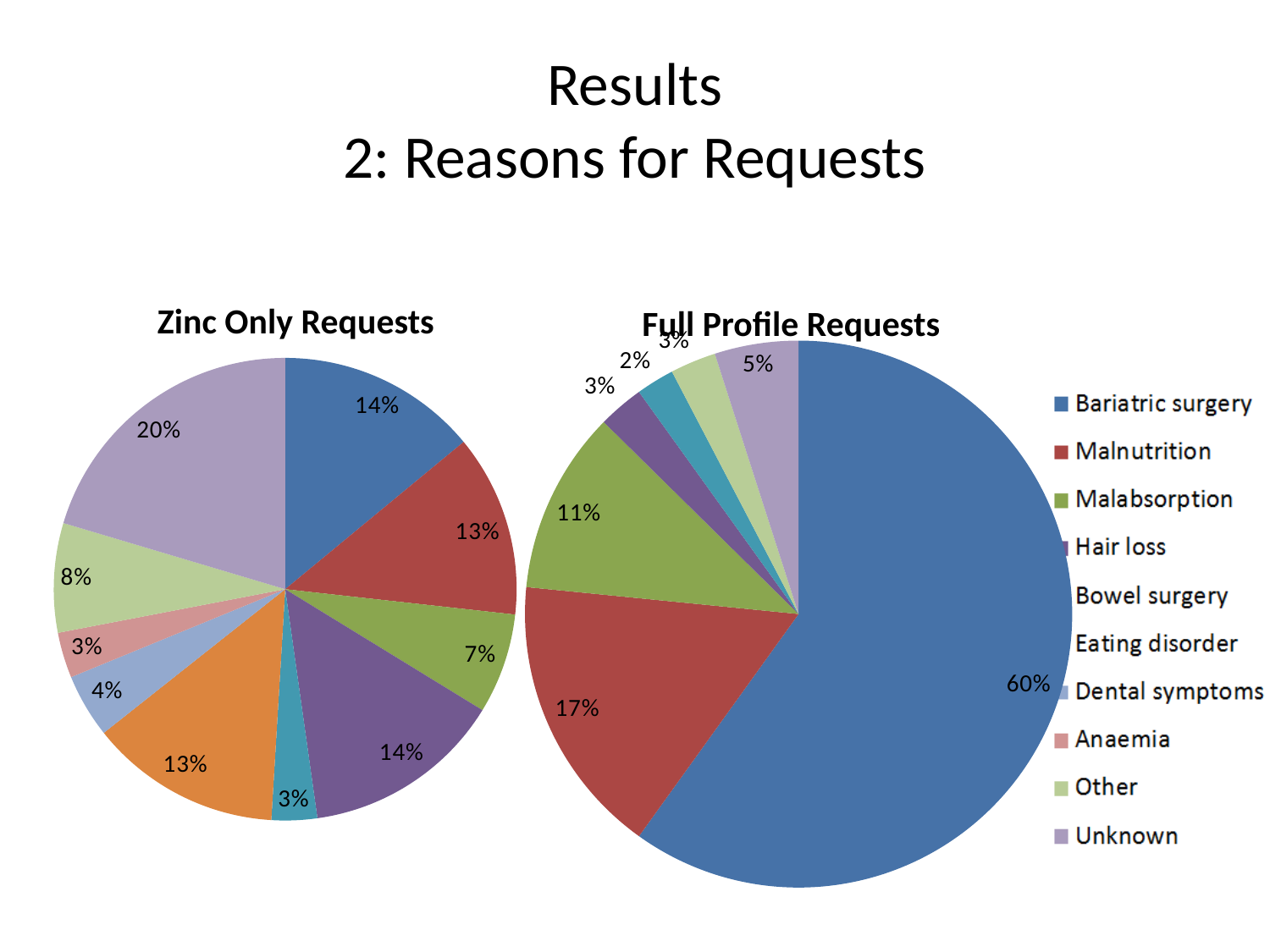
In the Full Profile Requests chart, which reason has the largest share? Bariatric surgery In the Zinc Only Requests chart, which reason has the largest share? Unknown In the Zinc Only Requests chart, what share of requests is Eating disorder? 13% What type of chart is the Zinc Only Requests chart? Pie chart In the Full Profile Requests chart, what is the difference between the Malnutrition and Malabsorption shares? 6% How many reasons does the legend list? 10 In the Full Profile Requests chart, what share of requests is Bariatric surgery? 60% In the Zinc Only Requests chart, which reason has the smallest share, Malabsorption or Other? Malabsorption In the Zinc Only Requests chart, what share of requests is Malabsorption? 7% In the Full Profile Requests chart, what share of requests is Malnutrition? 17% What is the difference between the Bariatric surgery share in the Full Profile Requests chart and in the Zinc Only Requests chart? 46% In the Zinc Only Requests chart, what share of requests is Unknown? 20%